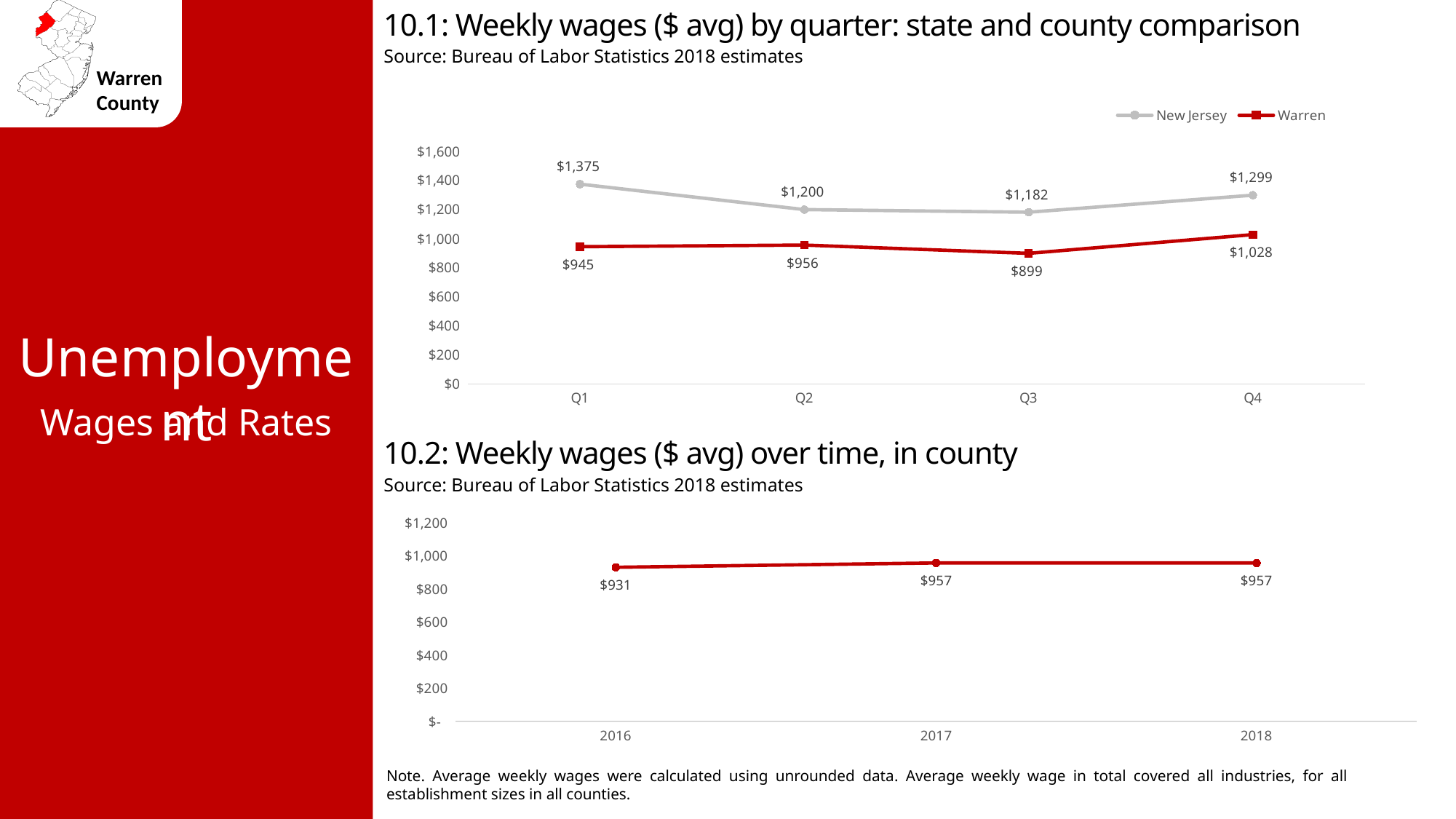
In chart 10.2, what is the weekly wage in 2016? $931 In chart 10.1, which is larger in Q2: the New Jersey wage or the Warren wage? New Jersey In chart 10.1, which quarter has the lowest New Jersey weekly wage? Q3 In chart 10.1, how many quarters are plotted on the x axis? 4 In chart 10.1, which series is drawn in red? Warren What kind of chart is chart 10.2? Line chart In chart 10.1, what is the Warren weekly wage in Q3? $899 In chart 10.1, how many series does the legend list? 2 In chart 10.1, what is the New Jersey weekly wage in Q1? $1,375 In chart 10.1, what is the difference between the New Jersey and Warren weekly wages in Q4? $271 In chart 10.1, which quarter has the highest Warren weekly wage? Q4 In chart 10.2, what is the difference between the 2017 and 2016 weekly wages? $26